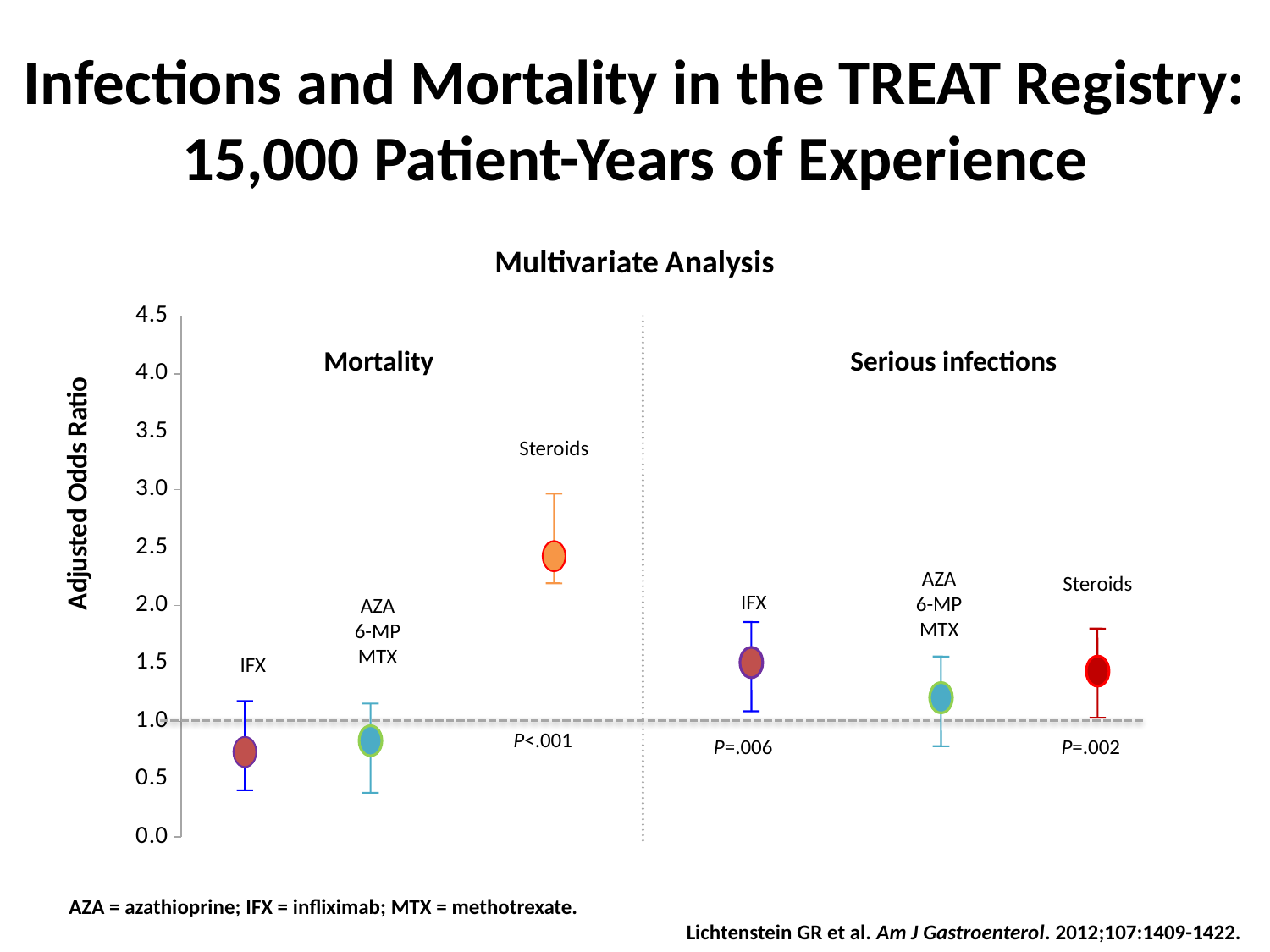
Is the adjusted odds ratio for Steroids in the Serious infections panel greater or less than 2.0? less In the Mortality panel, which treatment has the highest adjusted odds ratio? Steroids Is the adjusted odds ratio for IFX in the Serious infections panel greater or less than 1.0? greater Is the adjusted odds ratio for IFX in the Mortality panel greater or less than 1.0? less How many data points are plotted on the chart? 6 What is the label of the y axis? Adjusted Odds Ratio What P value is shown for Steroids in the Mortality panel? P<.001 In the Mortality panel, which has the larger adjusted odds ratio, Steroids or IFX? Steroids What is the title of the chart? Multivariate Analysis What P value is shown for Steroids in the Serious infections panel? P=.002 What kind of chart is shown on the slide? Scatter (dot) plot with error bars